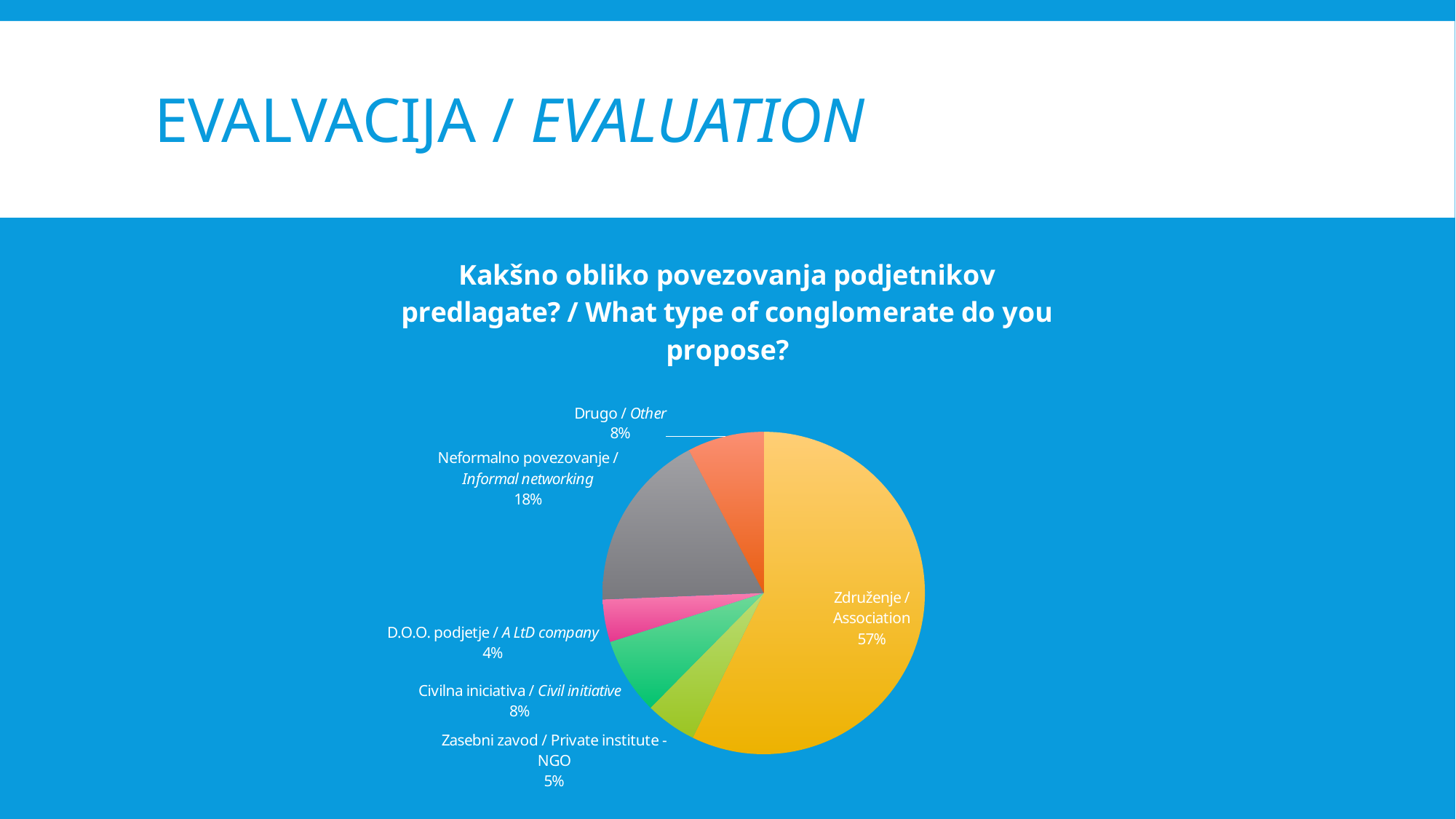
Which category has the largest slice of the pie? Združenje / Association What is the value for Neformalno povezovanje / Informal networking? 18% Which is larger, the share for Civilna iniciativa / Civil initiative or the share for Zasebni zavod / Private institute - NGO? Civilna iniciativa / Civil initiative What is the value for D.O.O. podjetje / A LtD company? 4% Which category has the smallest slice of the pie? D.O.O. podjetje / A LtD company What colour is the Združenje / Association slice? Yellow/orange What is the combined share of Drugo / Other and Civilna iniciativa / Civil initiative? 16% What share of the pie does Združenje / Association have? 57% What is the value for Zasebni zavod / Private institute - NGO? 5% How many slices does the pie chart have? 6 What is the difference between the shares of Združenje / Association and Neformalno povezovanje / Informal networking? 39 percentage points What type of chart is shown on the slide? Pie chart